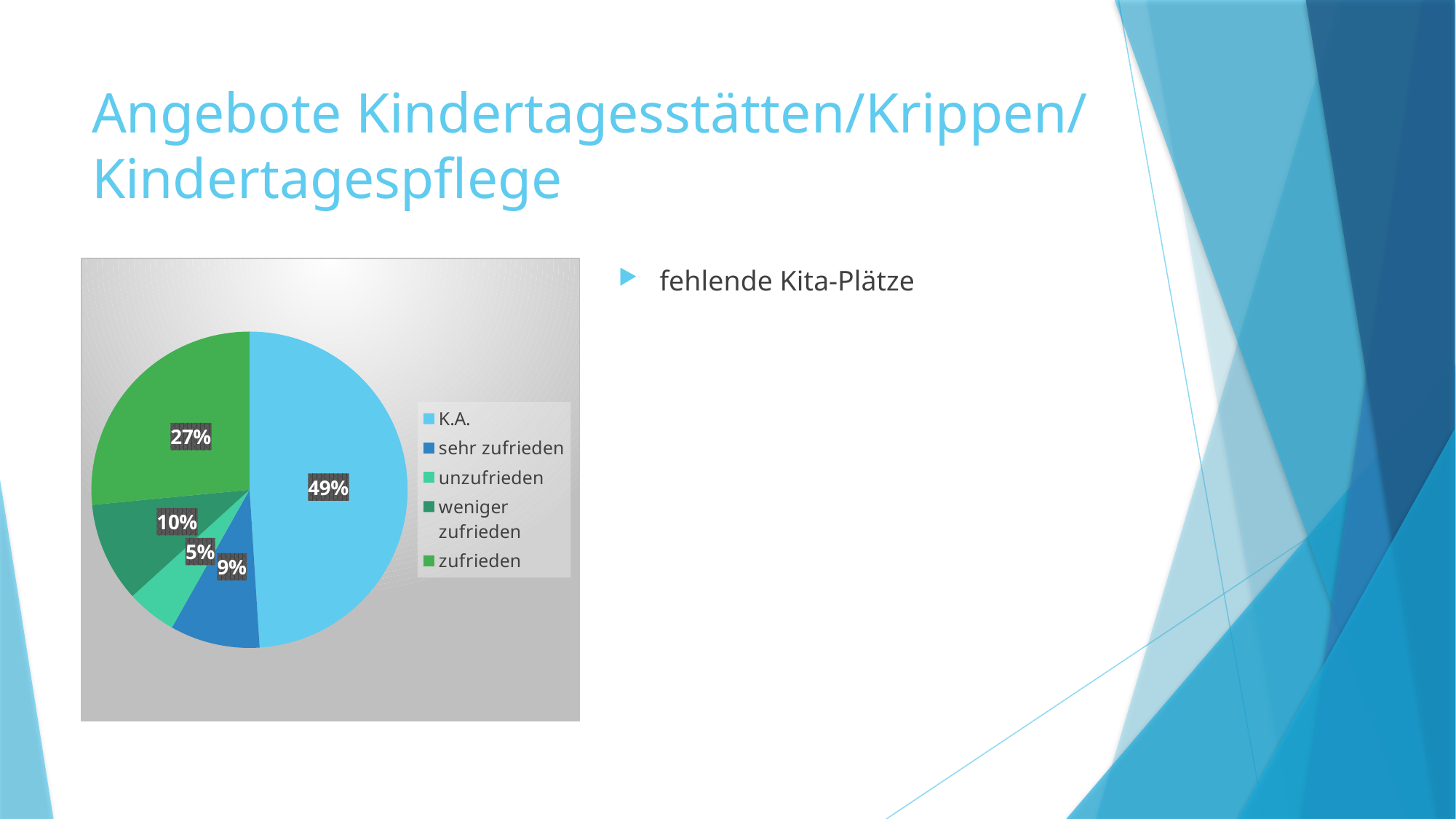
What is the difference in percentage points between K.A. and zufrieden? 22 What type of chart is shown on the slide? pie chart What percentage is shown for weniger zufrieden? 10% Which category has the largest slice of the pie? K.A. How many categories does the pie chart show? 5 What colour is the slice for zufrieden in the pie chart? green What percentage is shown for zufrieden? 27% What percentage is shown for unzufrieden? 5% Which is larger, the slice for weniger zufrieden or the slice for sehr zufrieden? weniger zufrieden What percentage is shown for sehr zufrieden? 9% Which category has the smallest slice of the pie? unzufrieden What share of the pie does K.A. represent? 49%